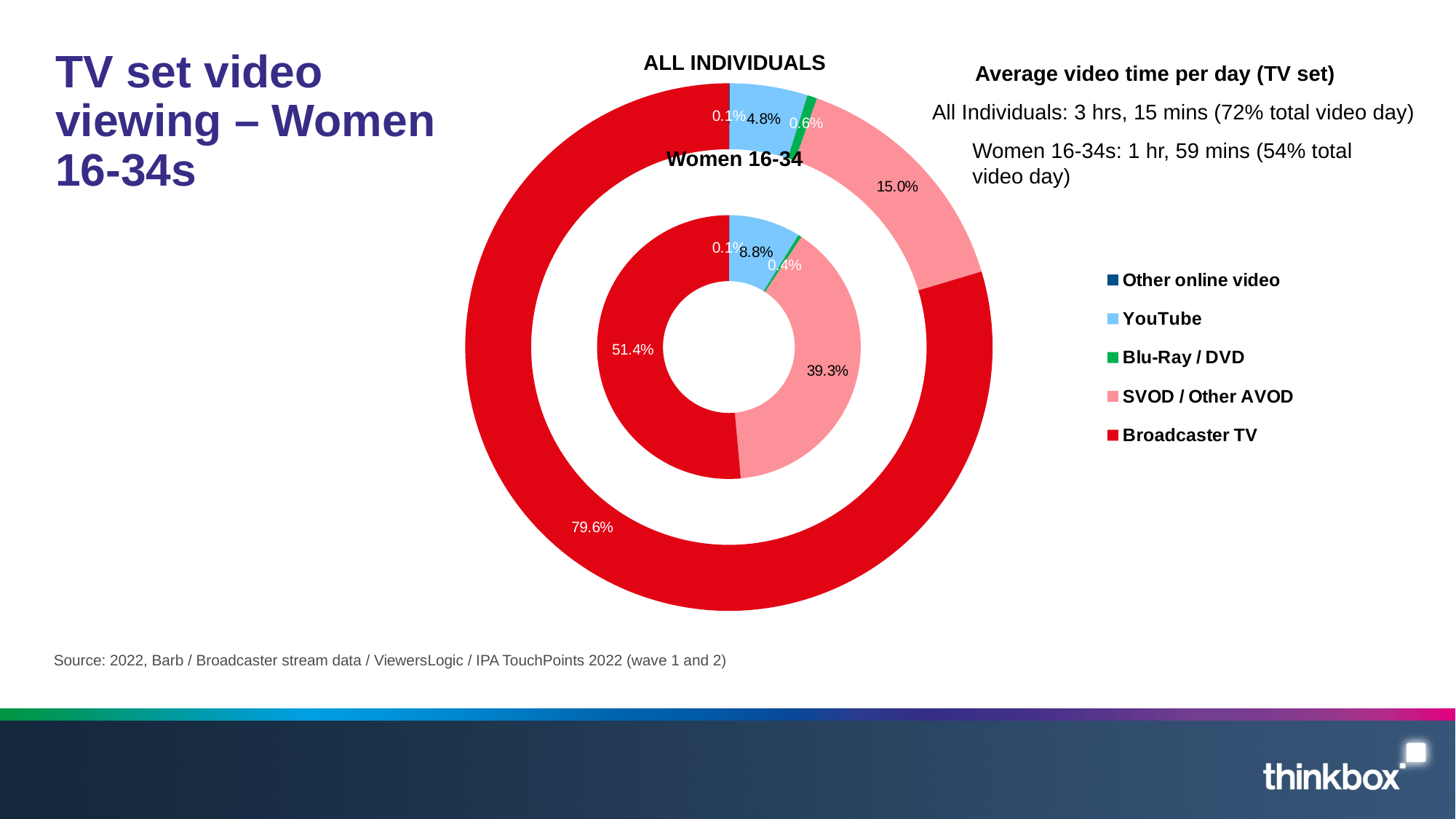
What share of TV set video viewing for All Individuals is Broadcaster TV? 79.6% Which group has the larger YouTube share, All Individuals or Women 16-34? Women 16-34 How much larger is the Broadcaster TV share for All Individuals than for Women 16-34? 28.2 percentage points Which colour represents SVOD / Other AVOD in the chart? Pink Which category has the largest share for Women 16-34? Broadcaster TV What is the YouTube share for Women 16-34 in the inner ring? 8.8% What is the Blu-Ray / DVD share for All Individuals in the outer ring? 0.6% How many categories does the legend list? 5 Which category has the smallest share for All Individuals? Other online video What is the difference between the SVOD / Other AVOD share for Women 16-34 and for All Individuals? 24.3 percentage points What share of TV set video viewing for Women 16-34 is SVOD / Other AVOD? 39.3% What type of chart is shown on the slide? Doughnut chart